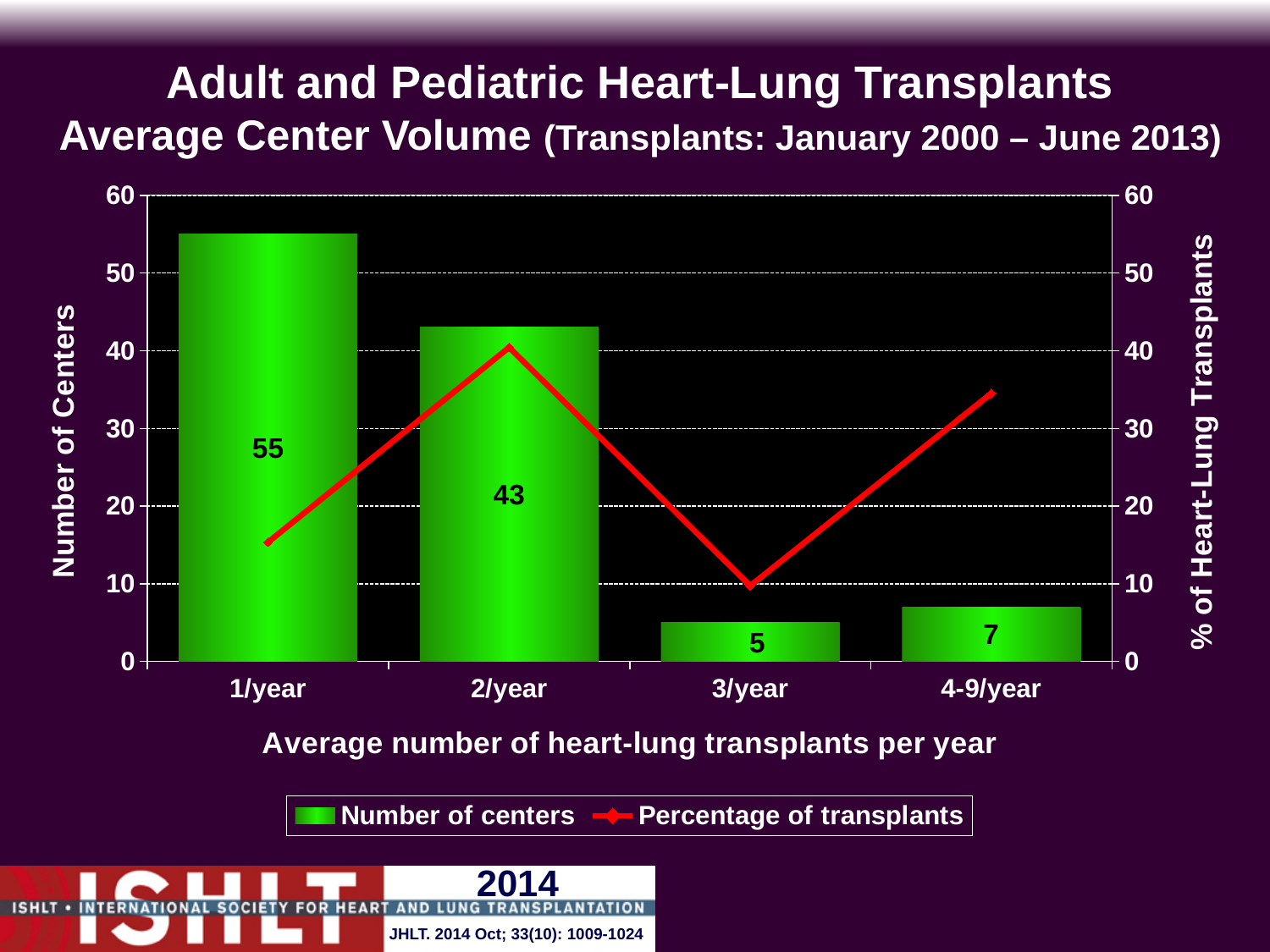
Which category has the highest number of centers? 1/year What is the number of centers for the 2/year category? 43 Which category has the lowest number of centers? 3/year How many categories are shown on the x axis? 4 Is the percentage of transplants for the 4-9/year category greater or less than 30? greater How many series does the legend list? 2 Which has more centers, the 3/year category or the 4-9/year category? 4-9/year Is the percentage of transplants for the 1/year category greater or less than 20? less What is the number of centers for the 1/year category? 55 What is the label of the right-hand y axis? % of Heart-Lung Transplants What is the number of centers for the 4-9/year category? 7 What is the difference in number of centers between the 1/year and 2/year categories? 12